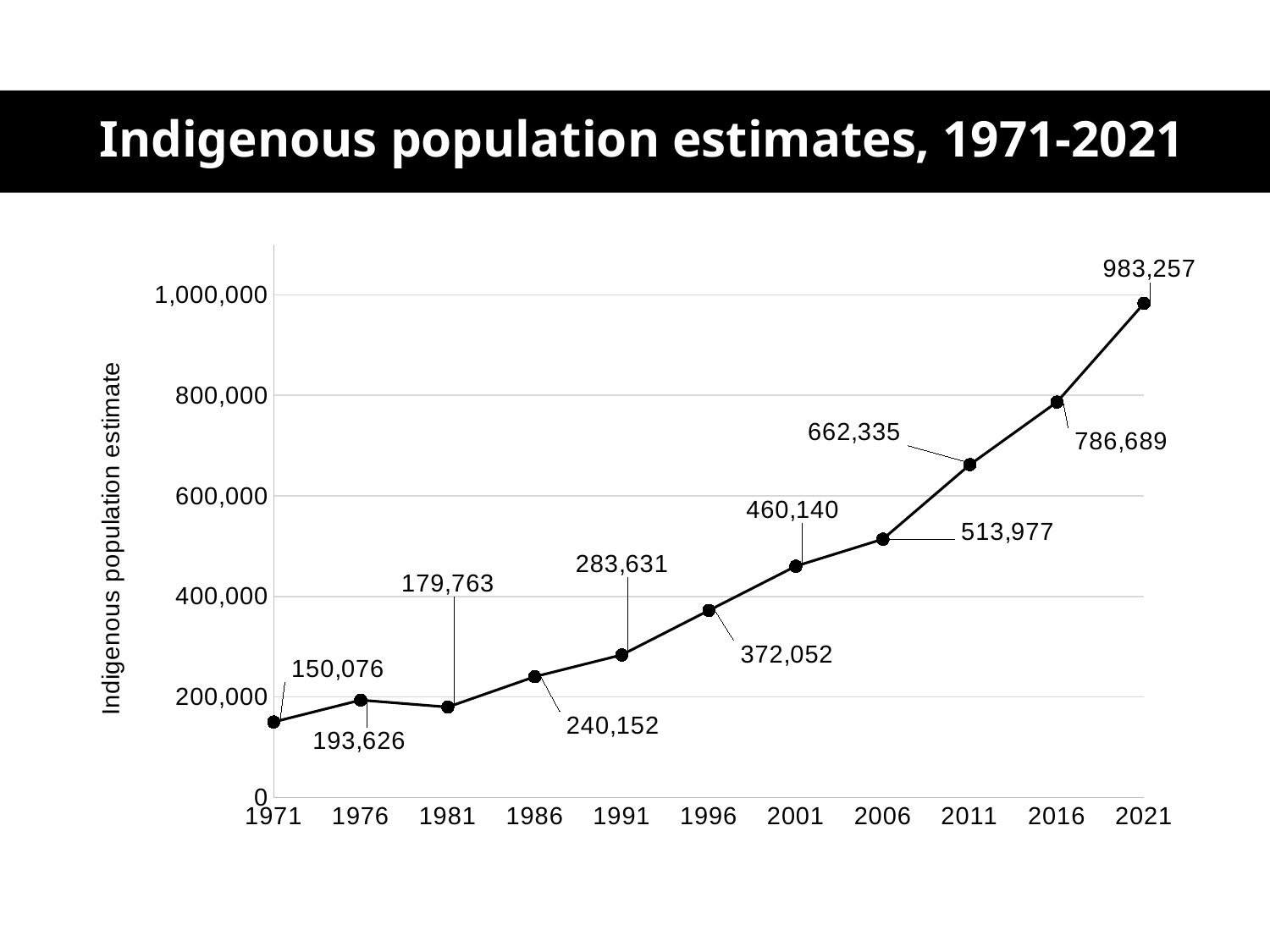
How many years are plotted on the chart? 11 What is the Indigenous population estimate for 2006? 513,977 Which year has the lowest Indigenous population estimate? 1971 What is the label of the vertical axis? Indigenous population estimate Is the Indigenous population estimate for 2011 greater or less than 600,000? greater What is the Indigenous population estimate for 1991? 283,631 What kind of chart is shown on the slide? line chart Which year has the highest Indigenous population estimate? 2021 What is the difference between the Indigenous population estimates for 2021 and 2016? 196,568 What is the Indigenous population estimate for 2021? 983,257 What is the difference between the Indigenous population estimates for 1976 and 1981? 13,863 Which year has a larger Indigenous population estimate, 1976 or 1981? 1976